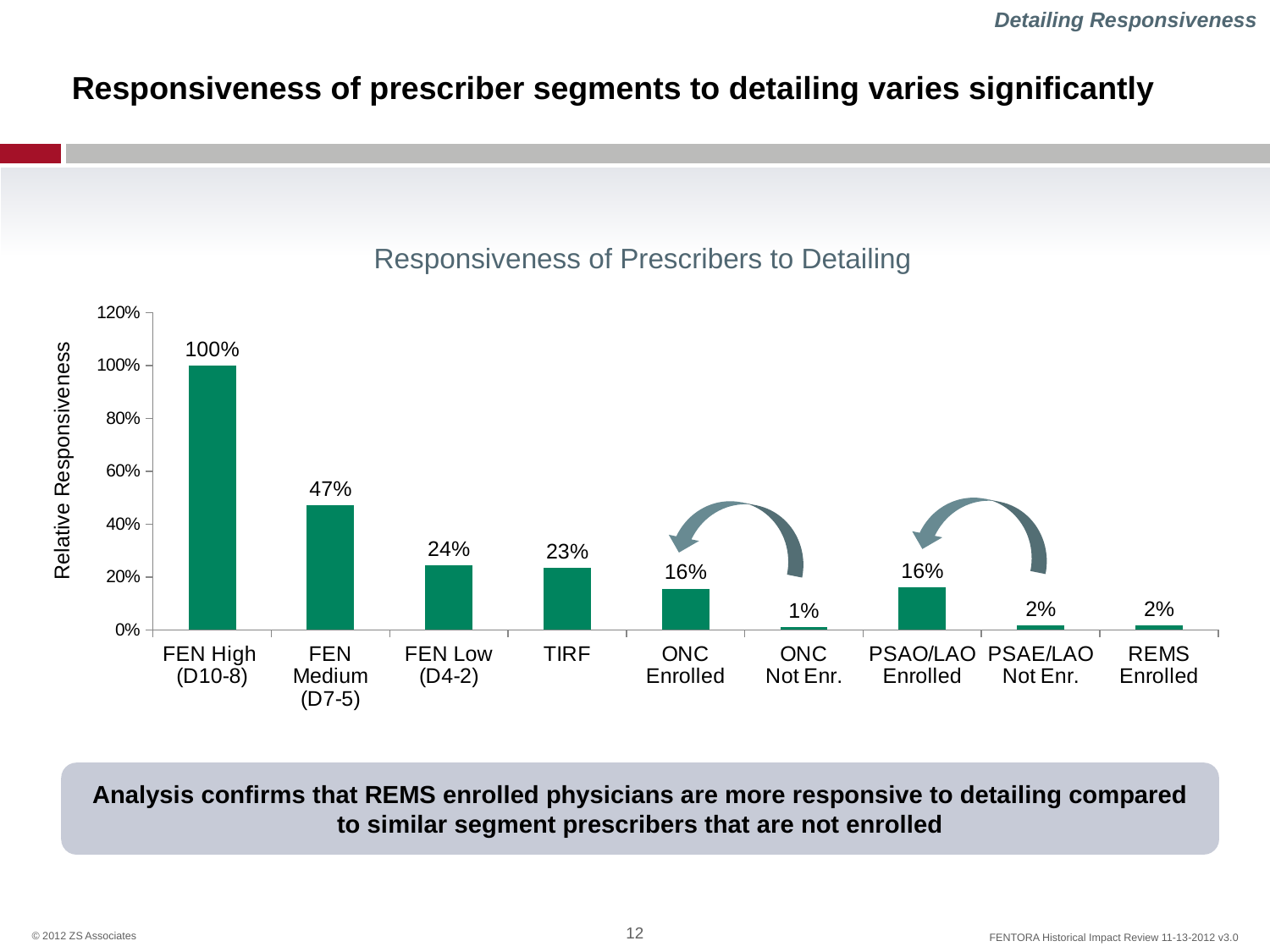
What is the relative responsiveness for FEN Medium (D7-5)? 47% How many categories are shown on the x axis of the chart? 9 What is the relative responsiveness for PSAO/LAO Enrolled? 16% What is the relative responsiveness for FEN High (D10-8)? 100% Which has a higher relative responsiveness, FEN Low (D4-2) or TIRF? FEN Low (D4-2) What type of chart is shown on the slide? Bar chart What is the title of the chart? Responsiveness of Prescribers to Detailing What is the difference in relative responsiveness between FEN High (D10-8) and FEN Medium (D7-5)? 53% Which category has the highest relative responsiveness? FEN High (D10-8) Which category has the lowest relative responsiveness? ONC Not Enr. What is the relative responsiveness for ONC Not Enr.? 1% What is the difference in relative responsiveness between ONC Enrolled and ONC Not Enr.? 15%